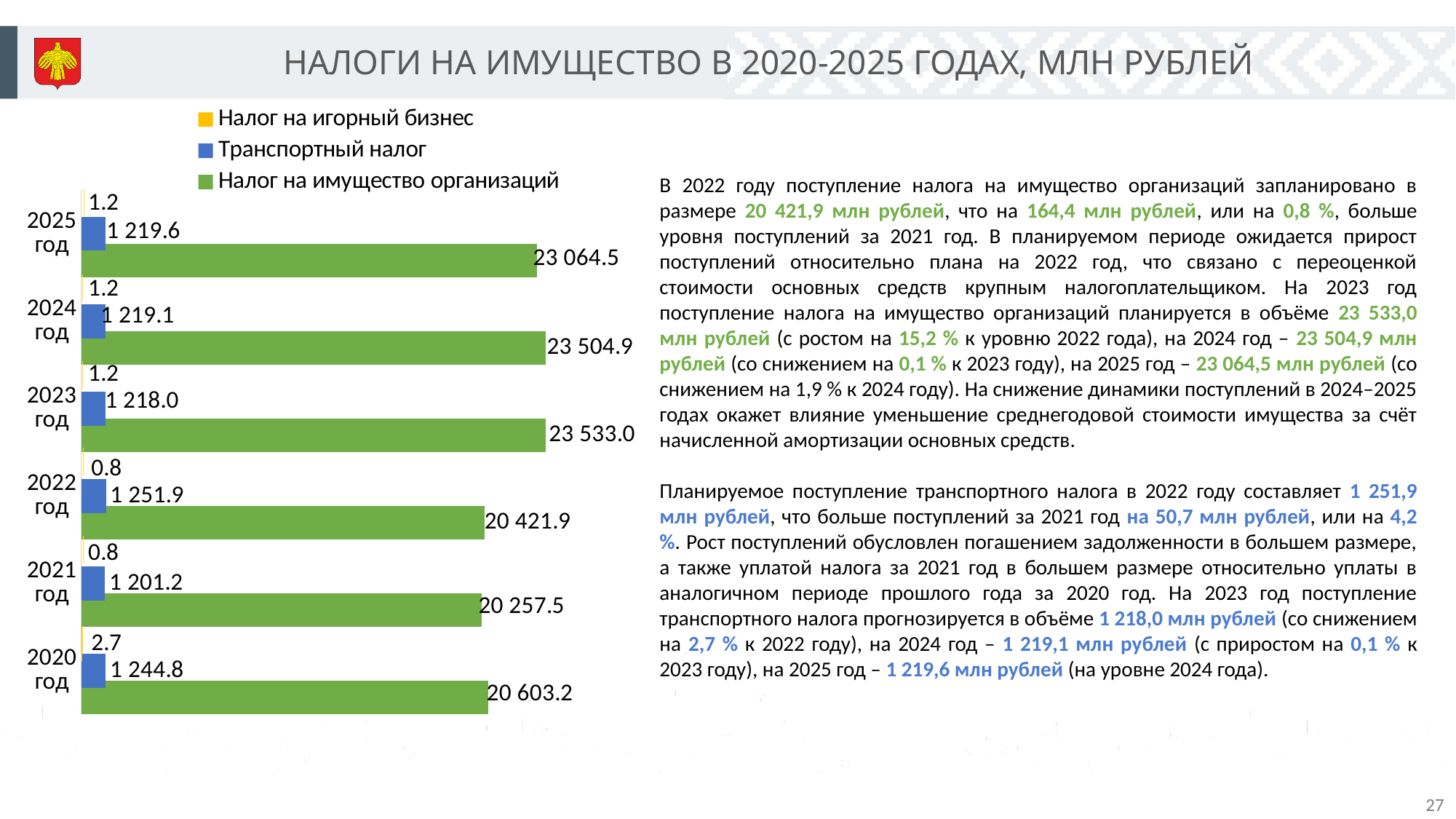
Which year has the highest value for Налог на имущество организаций? 2023 год What is the value of Транспортный налог for 2022 год? 1 251.9 What is the difference between the Транспортный налог values for 2022 год and 2021 год? 50.7 What is the value of Налог на имущество организаций for 2023 год? 23 533.0 Which year has the lowest value for Транспортный налог? 2021 год How many years are shown on the chart? 6 Which is larger: Транспортный налог for 2020 год or for 2025 год? 2020 год What kind of chart is shown on the slide? Bar chart Which series is shown in green on the chart? Налог на имущество организаций What is the value of Налог на игорный бизнес for 2020 год? 2.7 How many series does the legend list? 3 What is the difference between the Налог на имущество организаций values for 2023 год and 2022 год? 3 111.1